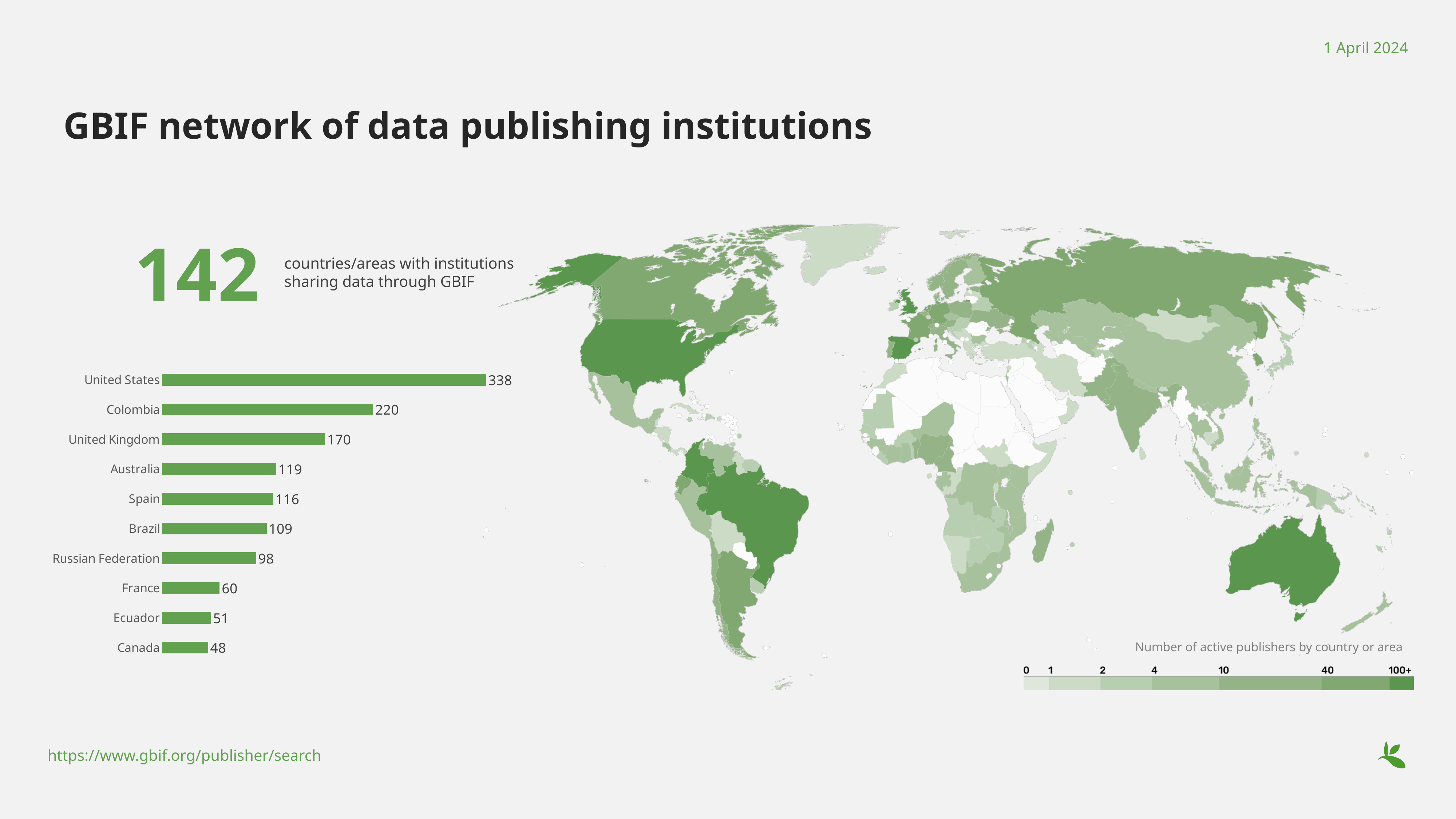
In the bar chart on the left, what is the value for Colombia? 220 How many countries are shown in the bar chart on the left? 10 In the bar chart on the left, what is the value for Canada? 48 In the bar chart on the left, what is the difference between the values for the United States and Colombia? 118 In the bar chart on the left, which is larger, the value for France or the value for Ecuador? France In the bar chart on the left, which is larger, the value for the United Kingdom or the value for Brazil? United Kingdom According to the map legend, what is the highest category label on the colour scale for number of active publishers? 100+ In the bar chart on the left, which country has the lowest value? Canada What kind of chart is shown on the left of the slide? Bar chart In the bar chart on the left, what is the difference between the values for Australia and Spain? 3 In the bar chart on the left, which country has the highest value? United States In the bar chart on the left, what is the value for the Russian Federation? 98